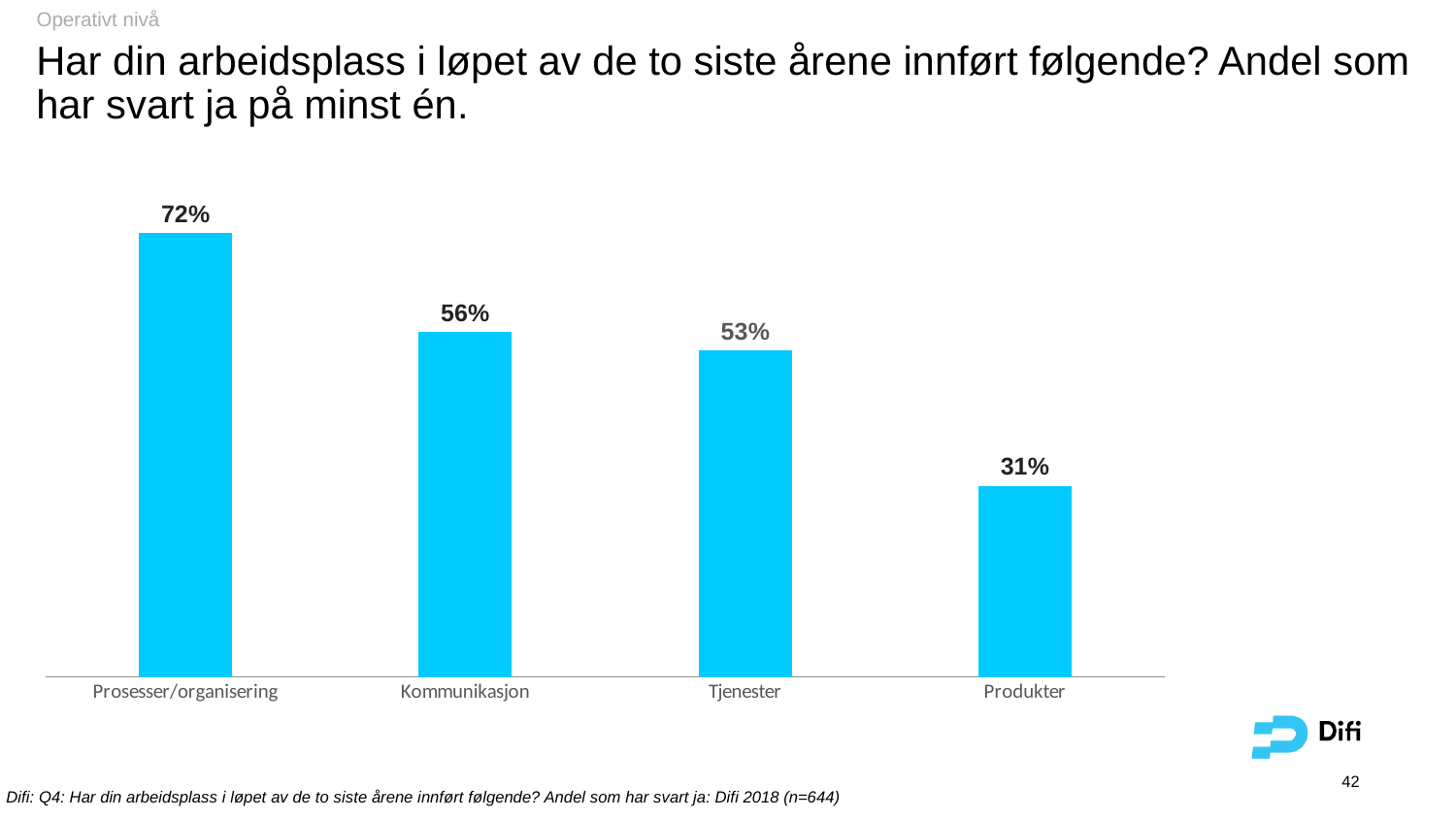
Which category has the highest value? Prosesser/organisering Which category has the lowest value? Produkter What kind of chart is shown on the slide? Bar chart What is the value for Prosesser/organisering? 72% What is the value for Kommunikasjon? 56% Do the values rise or fall from left to right across the categories? Fall How many categories are shown in the chart? 4 What is the value for Tjenester? 53% What is the value for Produkter? 31% Which is larger, the value for Kommunikasjon or the value for Produkter? Kommunikasjon What is the difference between the values for Kommunikasjon and Tjenester? 3 percentage points What is the difference between the values for Prosesser/organisering and Produkter? 41 percentage points